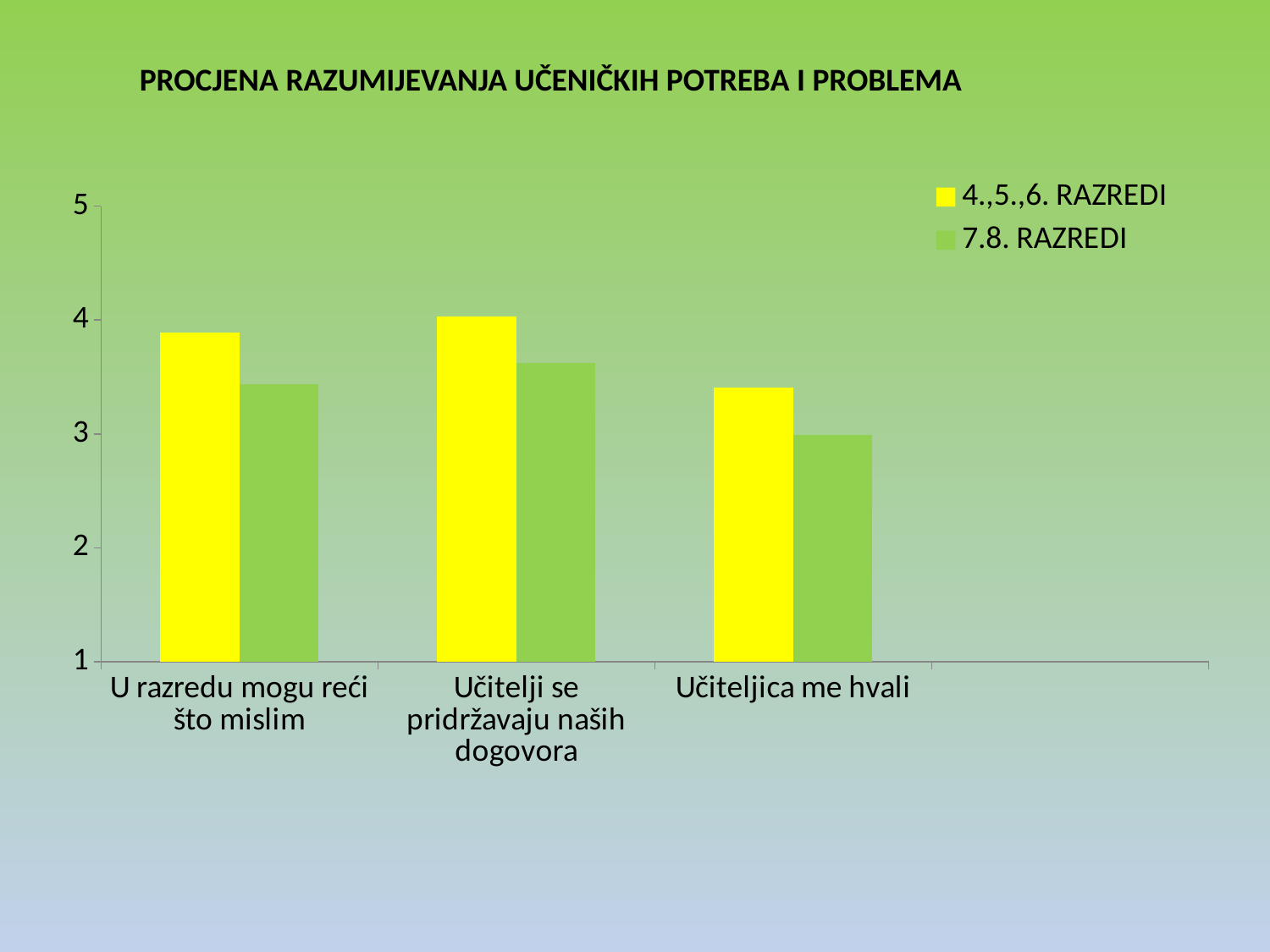
For the category 'Učiteljica me hvali', which series has the larger value, 4.,5.,6. RAZREDI or 7.8. RAZREDI? 4.,5.,6. RAZREDI For the category 'U razredu mogu reći što mislim', which series has the larger value, 4.,5.,6. RAZREDI or 7.8. RAZREDI? 4.,5.,6. RAZREDI Is the value for 4.,5.,6. RAZREDI in the category 'Učiteljica me hvali' greater or less than 4? less Is the value for 7.8. RAZREDI in the category 'Učitelji se pridržavaju naših dogovora' greater or less than 3? greater What is the title of the chart? PROCJENA RAZUMIJEVANJA UČENIČKIH POTREBA I PROBLEMA For the 4.,5.,6. RAZREDI series, which category has the highest value? Učitelji se pridržavaju naših dogovora How many series does the legend list? 2 Which colour represents the 7.8. RAZREDI series? green For the 4.,5.,6. RAZREDI series, which category has the lowest value? Učiteljica me hvali For the 7.8. RAZREDI series, which category has the lowest value? Učiteljica me hvali How many categories are shown on the x axis? 3 What kind of chart is shown on the slide? bar chart